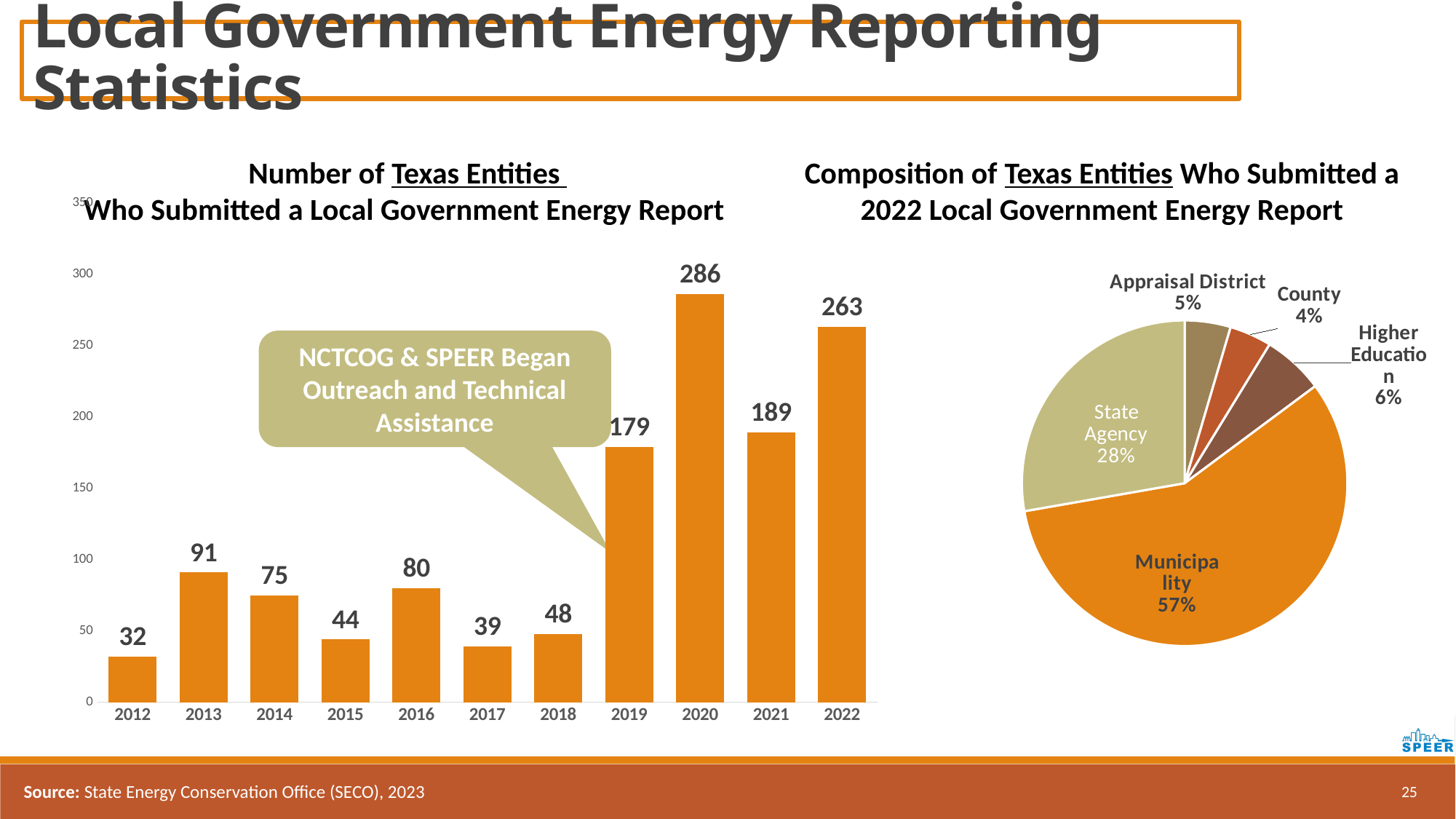
In the bar chart on the left, how many Texas entities submitted a Local Government Energy Report in 2020? 286 In the bar chart on the left, which year has the highest number of entities? 2020 In the bar chart on the left, which year has a larger value, 2016 or 2018? 2016 In the pie chart on the right, what share of entities are Municipalities? 57% In the bar chart on the left, which year has the lowest number of entities? 2012 In the pie chart on the right, how many categories are shown? 5 In the bar chart on the left, what is the difference between the values for 2022 and 2021? 74 What kind of chart is the chart on the left? bar chart In the bar chart on the left, what is the value for 2012? 32 In the pie chart on the right, which category has the smallest share? County In the bar chart on the left, how many years are shown on the x axis? 11 In the pie chart on the right, what share of entities are State Agencies? 28%